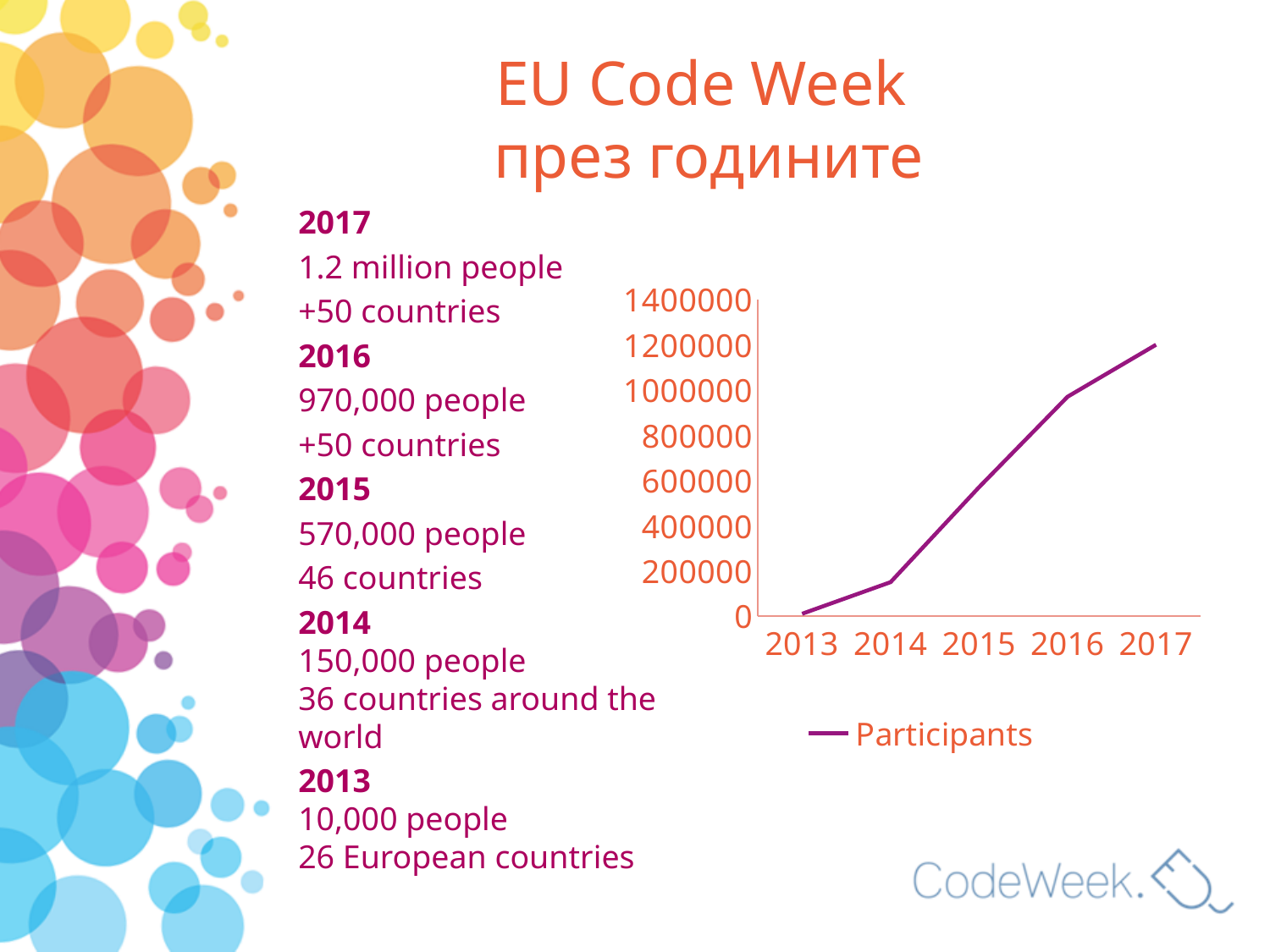
Which year has more participants, 2016 or 2015? 2016 Is the value for 2014 greater or less than 200000? less Is the value for 2015 greater or less than 400000? greater What is the highest value shown on the chart's vertical axis? 1400000 What is the name of the series shown in the chart legend? Participants How many years are plotted on the x axis of the chart? 5 Do the participant values rise or fall from 2013 to 2017? rise Which year has the lowest number of participants in the chart? 2013 Which year has the highest number of participants in the chart? 2017 Is the value for 2017 greater or less than 1000000? greater What kind of chart is shown on the slide? line chart How many series does the chart legend list? 1